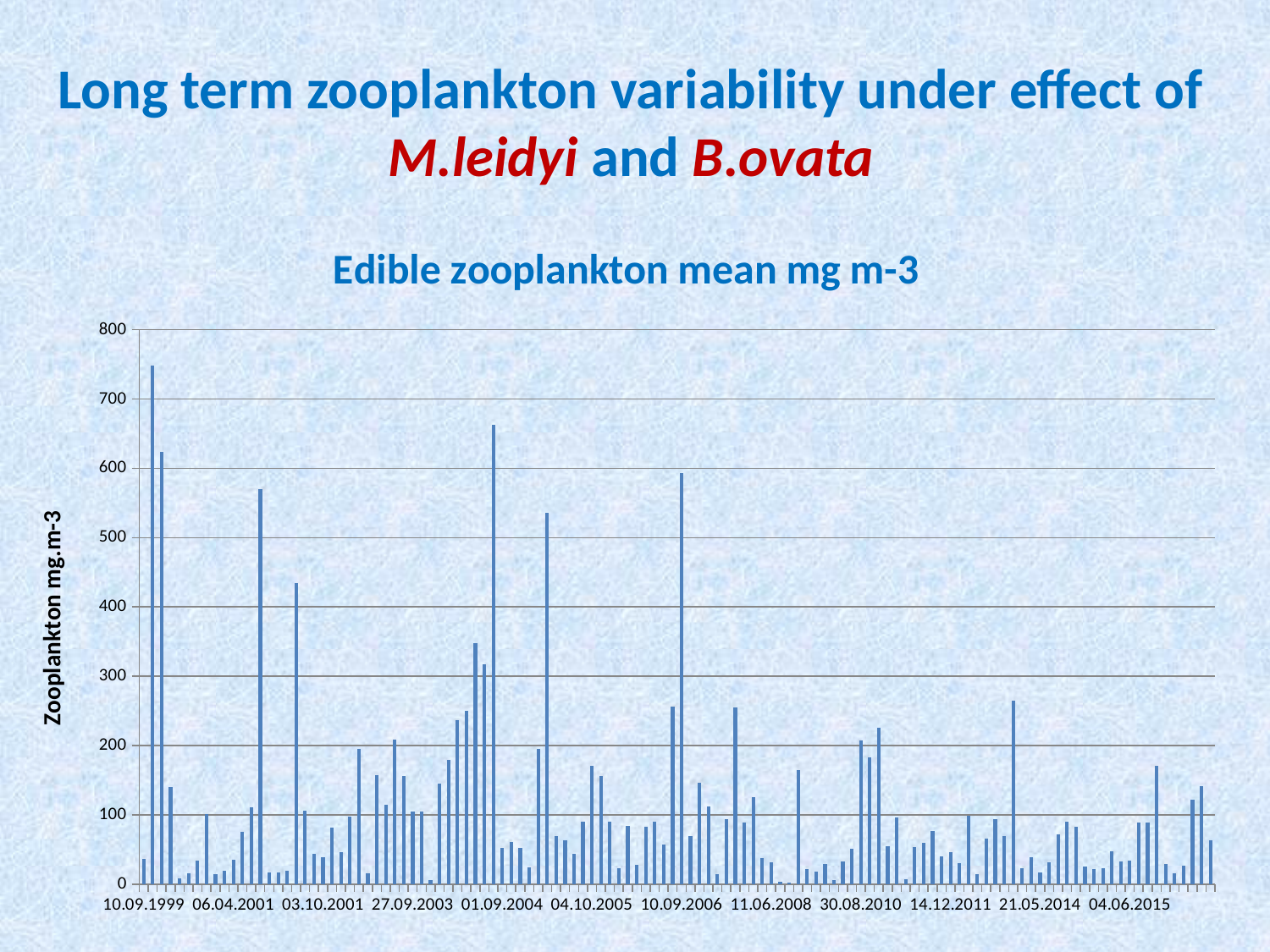
Is the tallest bar in the chart greater or less than 700? greater Is the tallest bar located in the left half or the right half of the chart? left half What is the label on the vertical axis of the chart? Zooplankton mg.m-3 What kind of chart is shown on the slide? bar chart How many date labels are printed along the x axis? 12 What is the title of the chart? Edible zooplankton mean mg m-3 Do the peak values of the bars generally rise or fall from left to right across the chart? fall How many data series are plotted in the chart? 1 Is the value for the first bar, at 10.09.1999, greater or less than 100? less Does any bar in the chart reach the 800 gridline? no